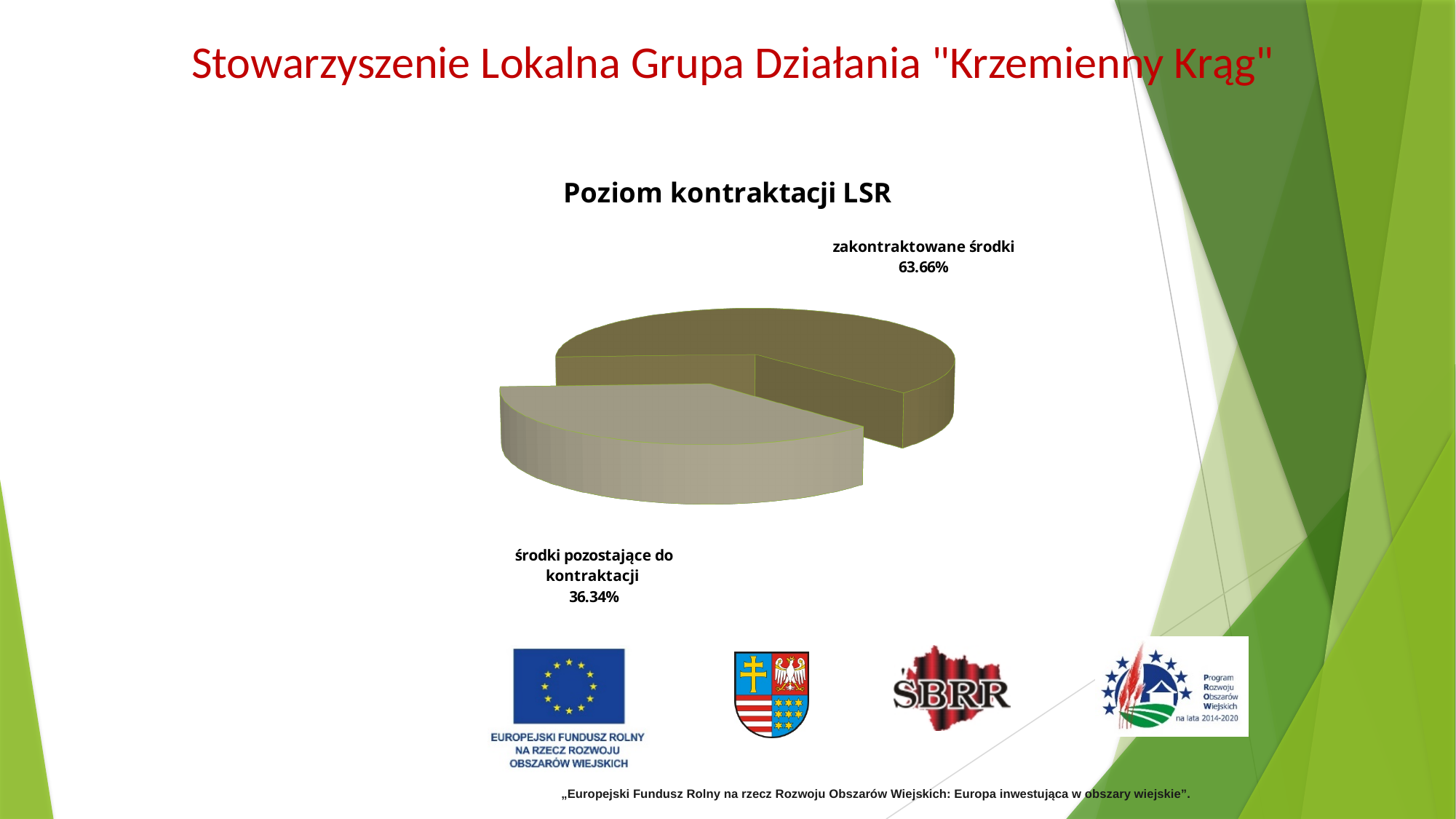
What is the difference in percentage points between the "zakontraktowane środki" slice and the "środki pozostające do kontraktacji" slice? 27.32 Which slice of the pie is the smallest? środki pozostające do kontraktacji Is the share for "środki pozostające do kontraktacji" greater or less than 50%? less What kind of chart is shown on the slide? pie chart What share of the pie is labelled "zakontraktowane środki"? 63.66% How many slices does the pie chart have? 2 Which is larger: the share for "zakontraktowane środki" or for "środki pozostające do kontraktacji"? zakontraktowane środki What is the title of the chart? Poziom kontraktacji LSR Which slice of the pie is the largest? zakontraktowane środki What share of the pie is labelled "środki pozostające do kontraktacji"? 36.34% Is the share for "zakontraktowane środki" greater or less than 50%? greater